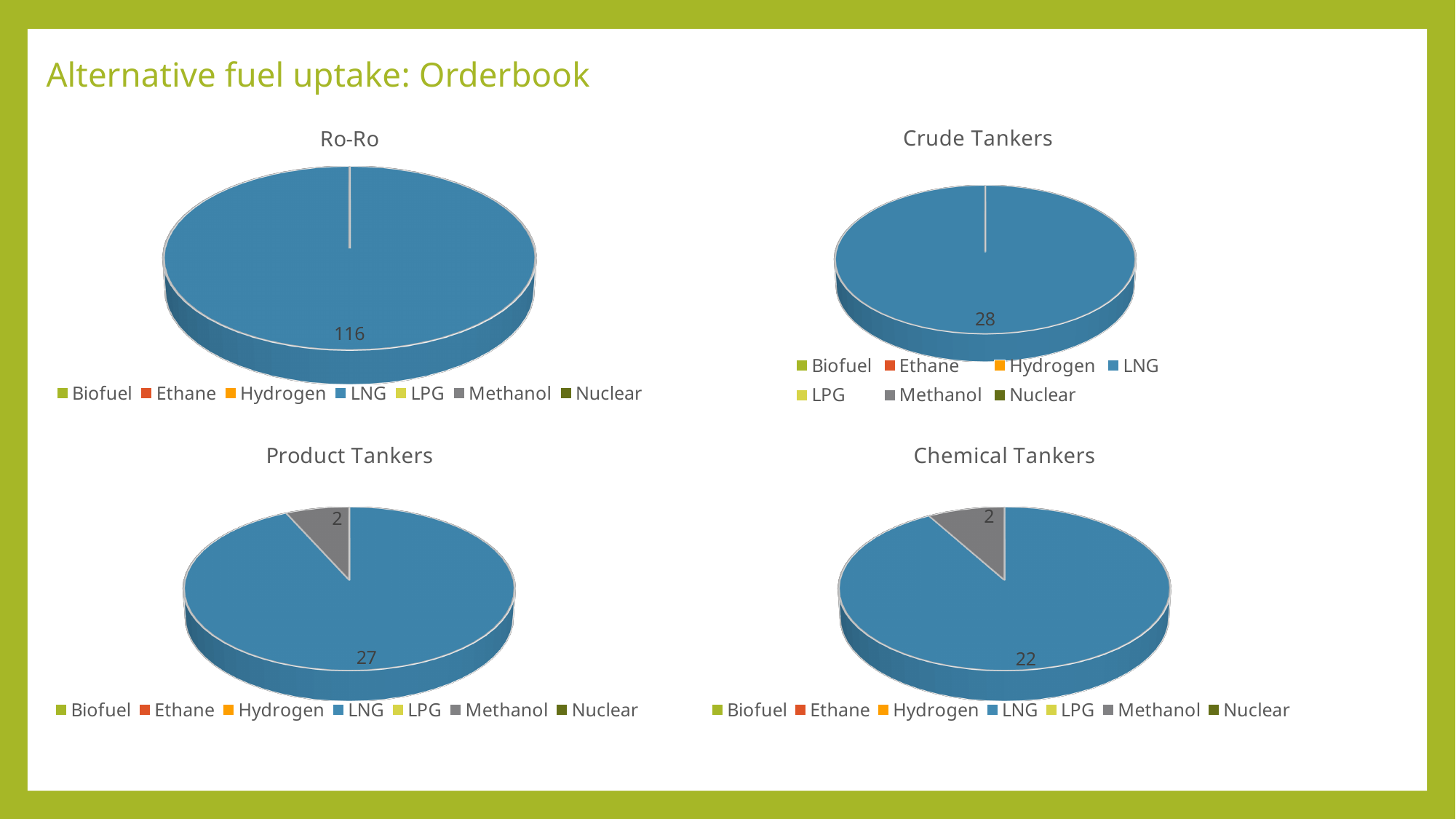
In the Product Tankers chart, what is the value shown for Methanol? 2 What type of chart is the Ro-Ro chart? Pie chart In the Product Tankers chart, what is the difference between the LNG value and the Methanol value? 25 In the Product Tankers chart, which fuel has the largest slice? LNG Which is larger: the LNG value in the Crude Tankers chart or the LNG value in the Product Tankers chart? Crude Tankers In the Crude Tankers chart, what is the value shown for LNG? 28 In the Chemical Tankers chart, which fuel has the smallest visible slice? Methanol In the Chemical Tankers chart, what is the value shown for LNG? 22 How many fuel types does the legend of the Chemical Tankers chart list? 7 What is the total of the values shown in the Chemical Tankers chart? 24 In the Ro-Ro chart, what is the value shown for LNG? 116 How many slices are visible in the Product Tankers pie chart? 2